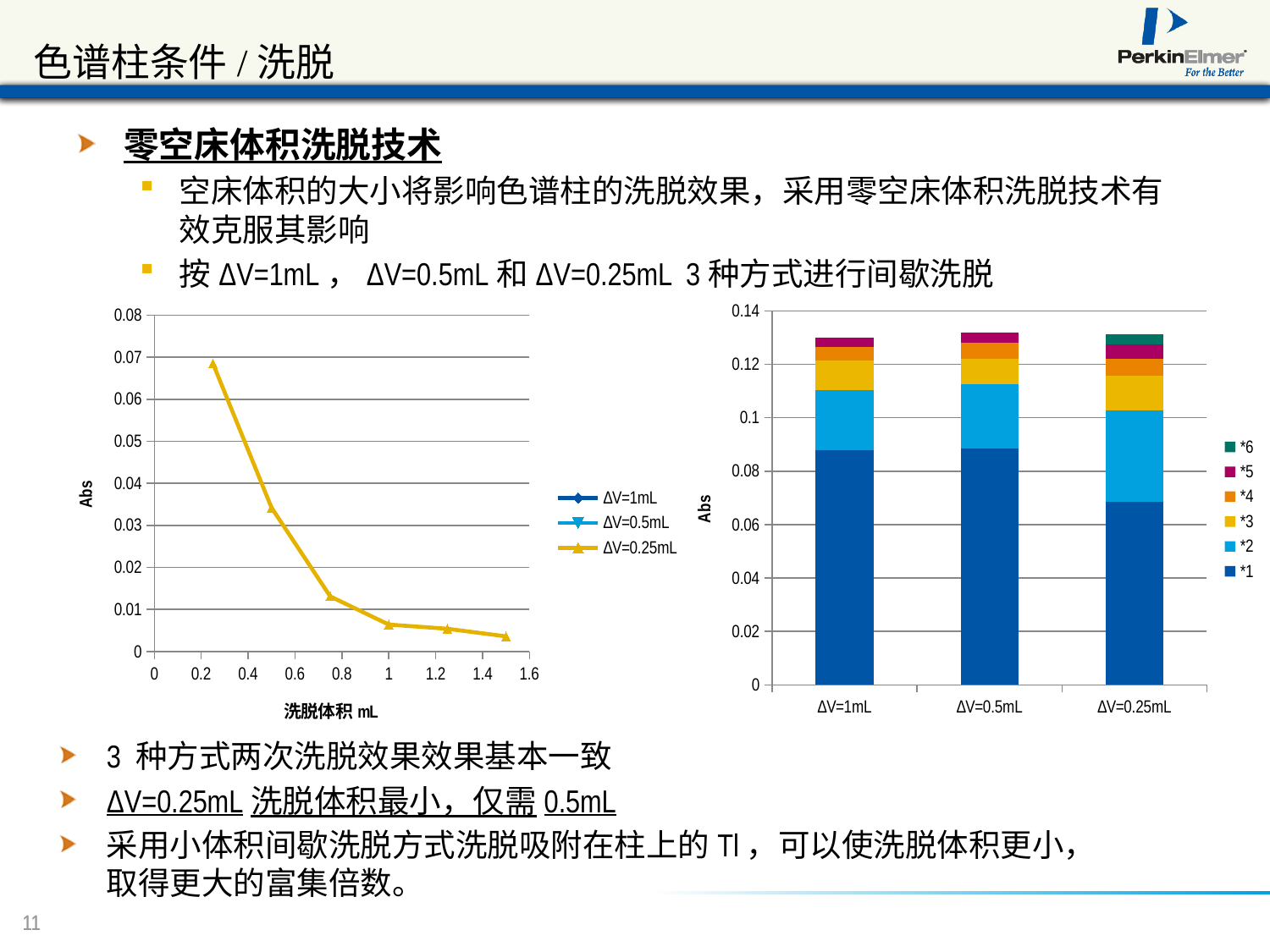
In the left chart, how many series does the legend list? 3 In the right chart, how many series does the legend list? 6 In the right chart, which category has the smallest *1 segment? ΔV=0.25mL In the left chart, do the values of the ΔV=0.25mL series rise or fall as 洗脱体积 increases? fall In the right chart, what is the label of the y axis? Abs What kind of chart is the chart on the left of the slide? line chart What kind of chart is the chart on the right of the slide? bar chart In the left chart, is the Abs value of the ΔV=0.25mL series at 洗脱体积 1 mL greater or less than 0.02? less In the left chart, is the Abs value of the ΔV=0.25mL series at 洗脱体积 0.25 mL greater or less than 0.06? greater In the right chart, is the *1 segment for ΔV=0.25mL greater or less than 0.08? less In the right chart, how many categories are shown on the x axis? 3